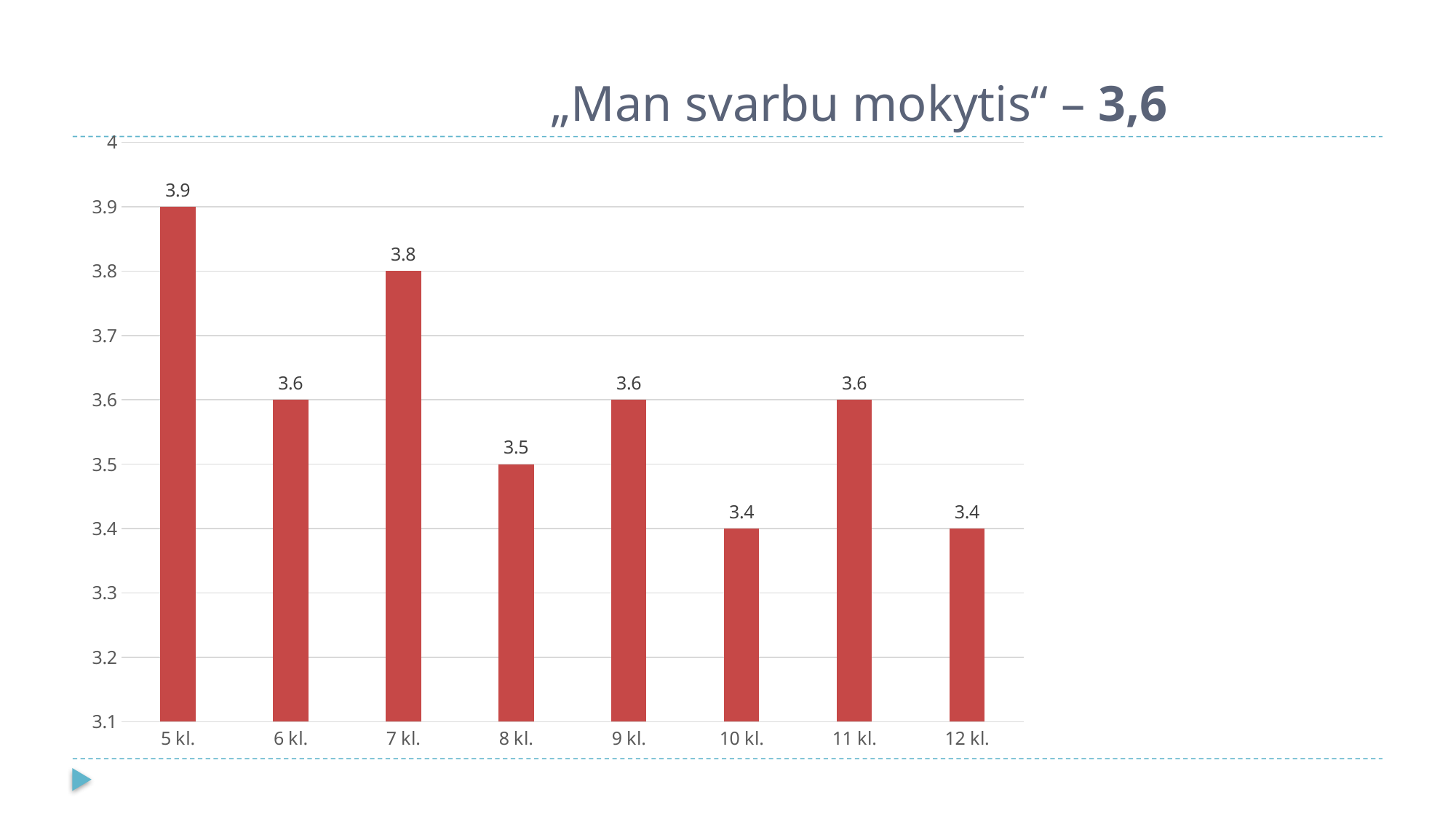
Which is larger, the value for 6 kl. or the value for 8 kl.? 6 kl. Which class has the highest value? 5 kl. Which is larger, the value for 7 kl. or the value for 9 kl.? 7 kl. What is the value for 8 kl.? 3.5 What is the title of the slide? „Man svarbu mokytis“ – 3,6 What is the value for 10 kl.? 3.4 What colour are the bars in the chart? Red How many classes are shown on the x axis? 8 What kind of chart is shown on the slide? Bar chart What is the value for 5 kl.? 3.9 What is the difference between the values for 5 kl. and 12 kl.? 0.5 What is the difference between the values for 7 kl. and 8 kl.? 0.3